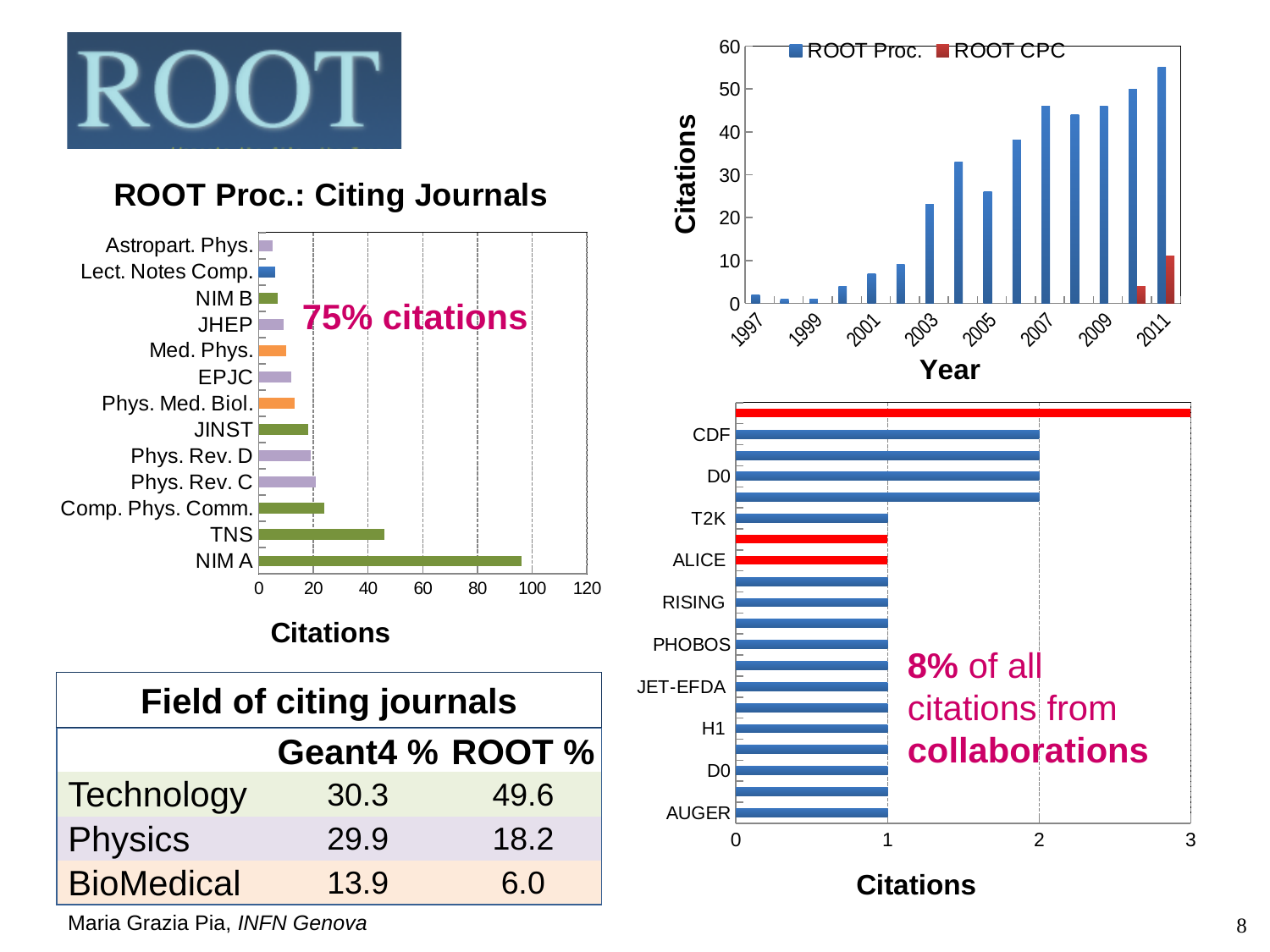
How many journals are listed in the 'ROOT Proc.: Citing Journals' chart? 13 In the top-right chart of citations by year, is the ROOT Proc. value for 2007 greater or less than 40? greater In the 'ROOT Proc.: Citing Journals' chart, which journal has the highest number of citations? NIM A In the 'ROOT Proc.: Citing Journals' chart, which journal has the lowest number of citations? Astropart. Phys. In the 'ROOT Proc.: Citing Journals' chart, is the value for NIM A greater or less than 80? greater What kind of chart is the bottom-right collaborations chart? bar chart In the 'ROOT Proc.: Citing Journals' chart, is the value for TNS greater or less than 40? greater In the top-right chart of citations by year, which year has the highest number of ROOT Proc. citations? 2011 In the bottom-right collaborations chart, what is the number of citations for CDF? 2 In the top-right chart of citations by year, do the ROOT Proc. citations generally rise or fall from 1997 to 2011? rise In the top-right chart of citations by year, how many series does the legend list? 2 In the 'ROOT Proc.: Citing Journals' chart, which has more citations, TNS or Comp. Phys. Comm.? TNS